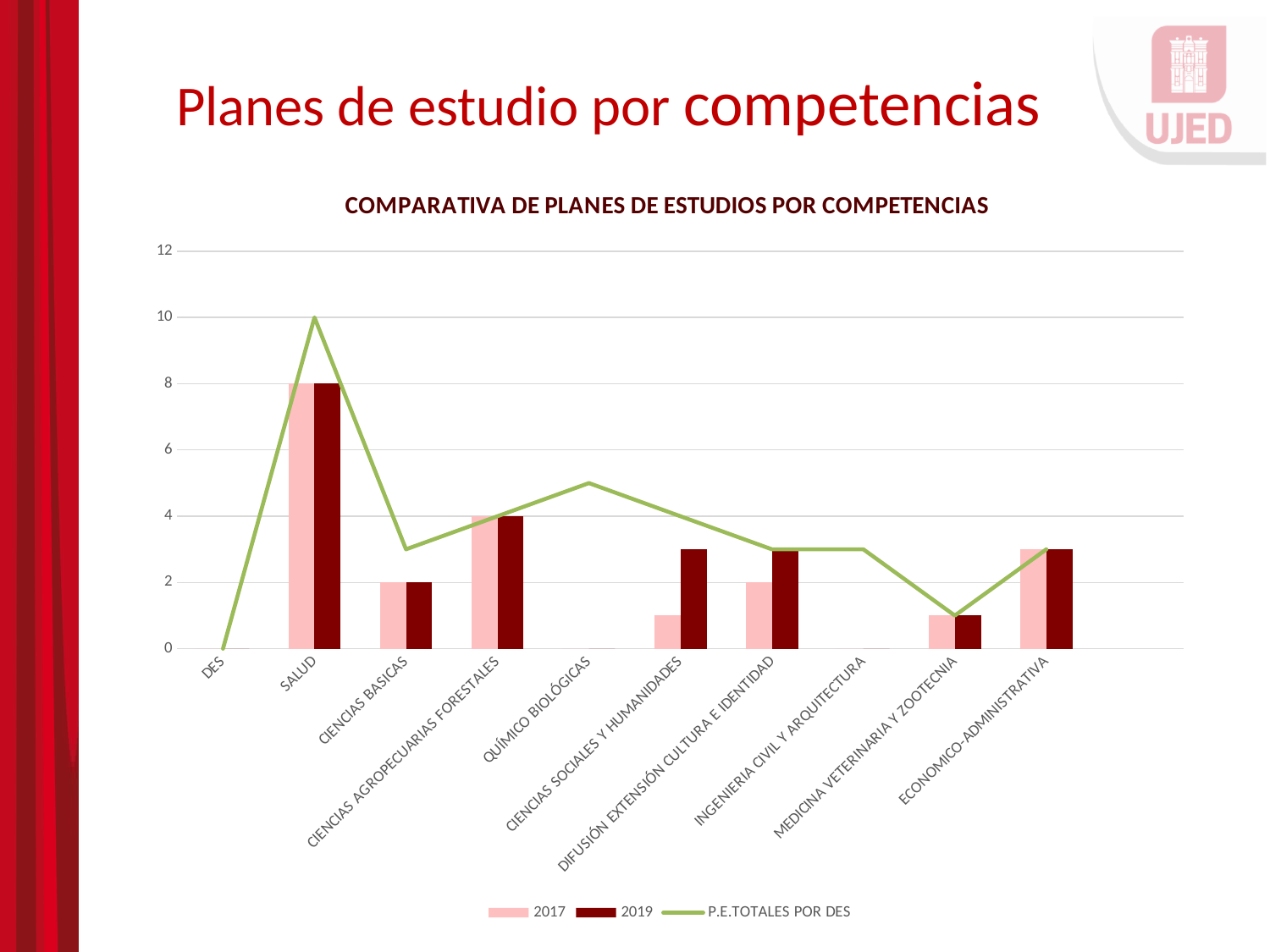
Is the 2019 value for MEDICINA VETERINARIA Y ZOOTECNIA greater or less than 2? less What is the P.E.TOTALES POR DES value for SALUD? 10 What is the title of the chart? COMPARATIVA DE PLANES DE ESTUDIOS POR COMPETENCIAS How many series does the legend list? 3 What is the difference between the 2017 values for SALUD and CIENCIAS BASICAS? 6 Which category has the highest 2019 value? SALUD Which category has the lowest P.E.TOTALES POR DES value? DES Is the P.E.TOTALES POR DES value for QUÍMICO BIOLÓGICAS greater or less than 4? greater How many categories are shown on the x axis? 10 For CIENCIAS SOCIALES Y HUMANIDADES, which is larger, the 2017 value or the 2019 value? 2019 What is the 2017 value for SALUD? 8 What is the 2019 value for CIENCIAS AGROPECUARIAS FORESTALES? 4